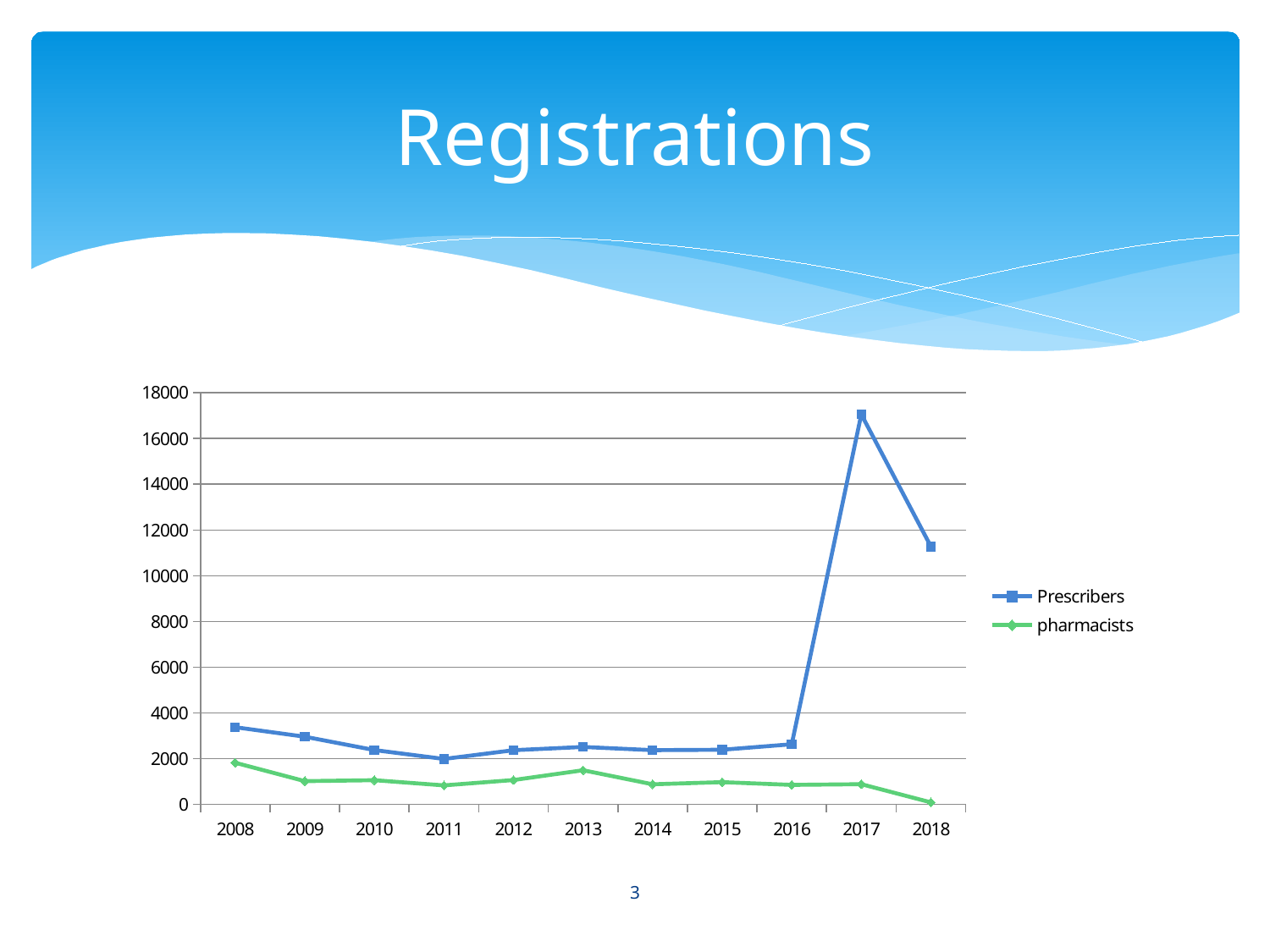
What are the two entries listed in the legend? Prescribers and pharmacists Is the Prescribers value for 2017 greater or less than 16000? greater In which year is the pharmacists value lowest? 2018 Does the Prescribers value rise or fall from 2017 to 2018? fall How many years are plotted along the x axis? 11 Is the pharmacists value for 2008 greater or less than 2000? less In which year is the Prescribers value highest? 2017 What kind of chart is shown on the slide? line chart In 2008, which series has the larger value, Prescribers or pharmacists? Prescribers Is the Prescribers value for 2018 greater or less than 12000? less How many series does the legend list? 2 In which year is the pharmacists value highest? 2008